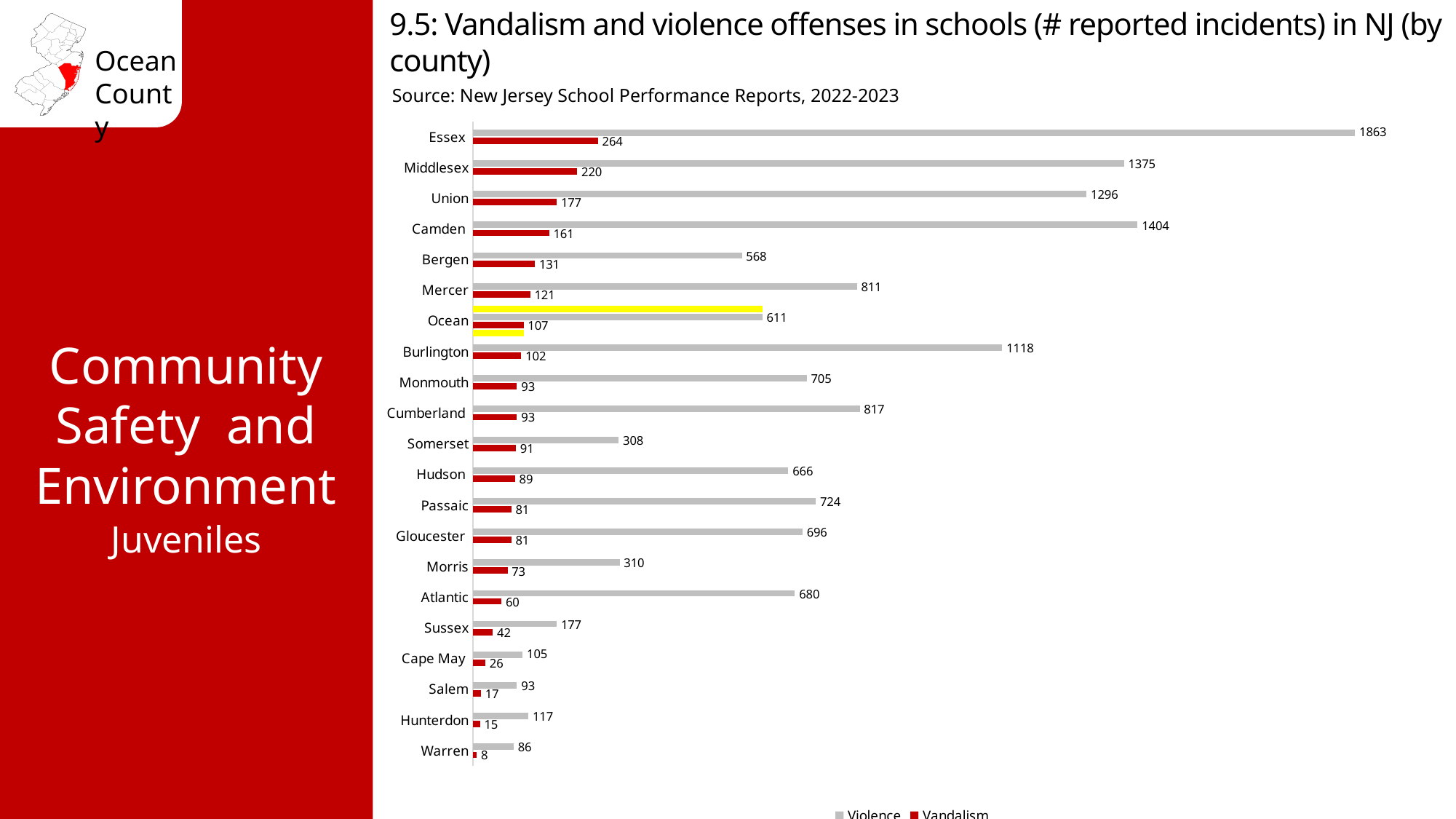
What is the number of reported vandalism incidents in Ocean County? 107 How many series does the legend list? 2 What is the number of reported violence incidents in Ocean County? 611 What is the number of reported vandalism incidents in Burlington County? 102 What kind of chart is shown on the slide? Bar chart Which series is shown in red on the chart? Vandalism What is the difference between violence and vandalism incidents in Bergen County? 437 What is the difference between the violence incidents in Essex and Middlesex? 488 Which county has the highest number of reported violence incidents? Essex Which county has the lowest number of reported vandalism incidents? Warren How many counties are shown on the chart? 21 Which county has more reported violence incidents, Camden or Union? Camden